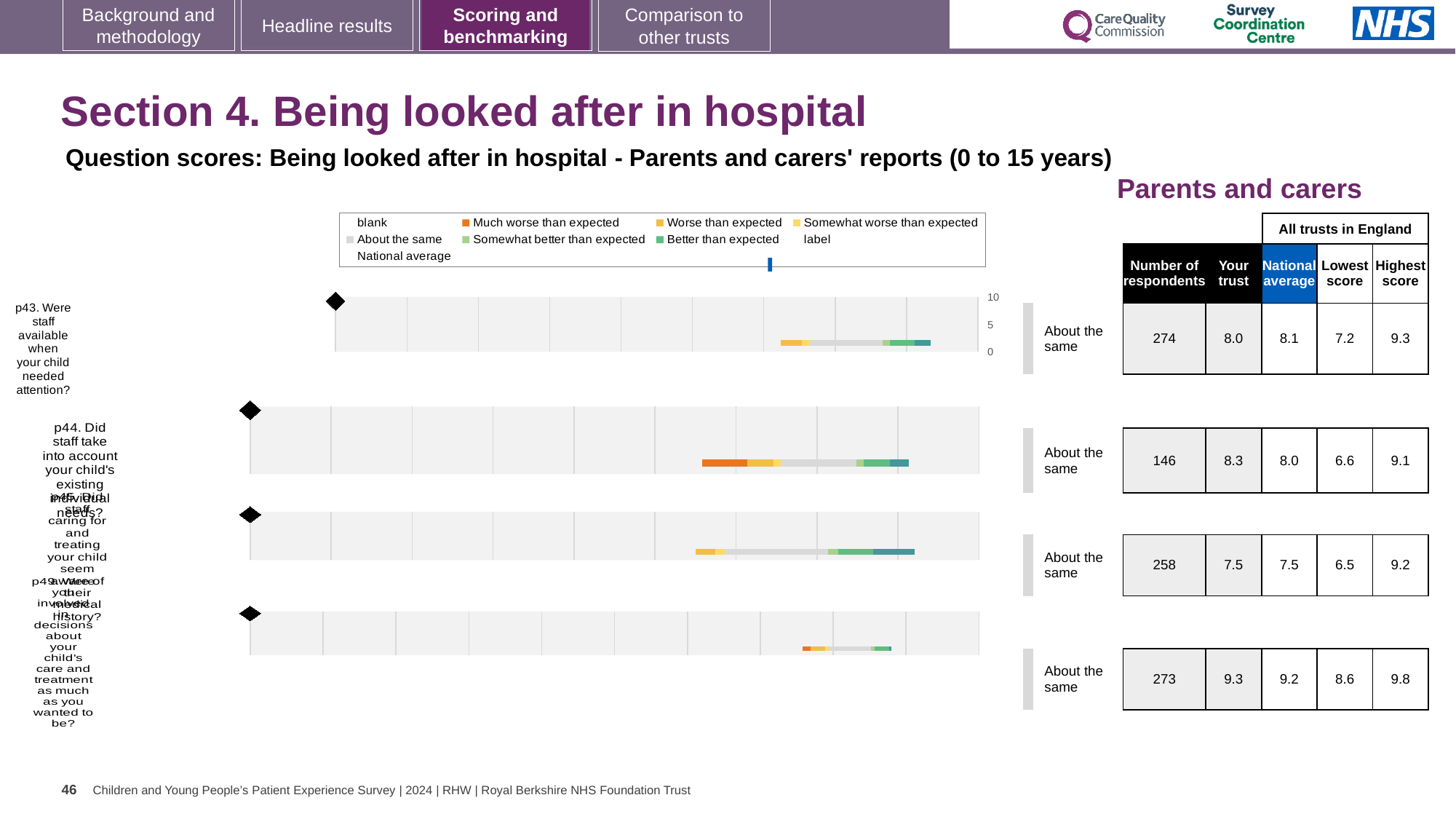
Which question has the highest 'Your trust' score? p49 What is the highest score across all trusts in England for question p49 (bottom bar)? 9.8 Which question has the lowest 'Your trust' score? p45 What kind of chart is used to show the question scores on this slide? Bar chart For question p43, which is larger: the 'Your trust' score or the national average? National average What benchmark category is shown for question p43? About the same What is the number of respondents for question p43 (Were staff available when your child needed attention?)? 274 What is the 'Your trust' score for question p44 (Did staff take into account your child's existing individual needs?)? 8.3 What is the national average score for question p45 (third bar from the top)? 7.5 For question p44, what is the difference between the 'Your trust' score and the national average? 0.3 What is the lowest score across all trusts in England for question p44? 6.6 How many questions (bars) are plotted in the chart? 4